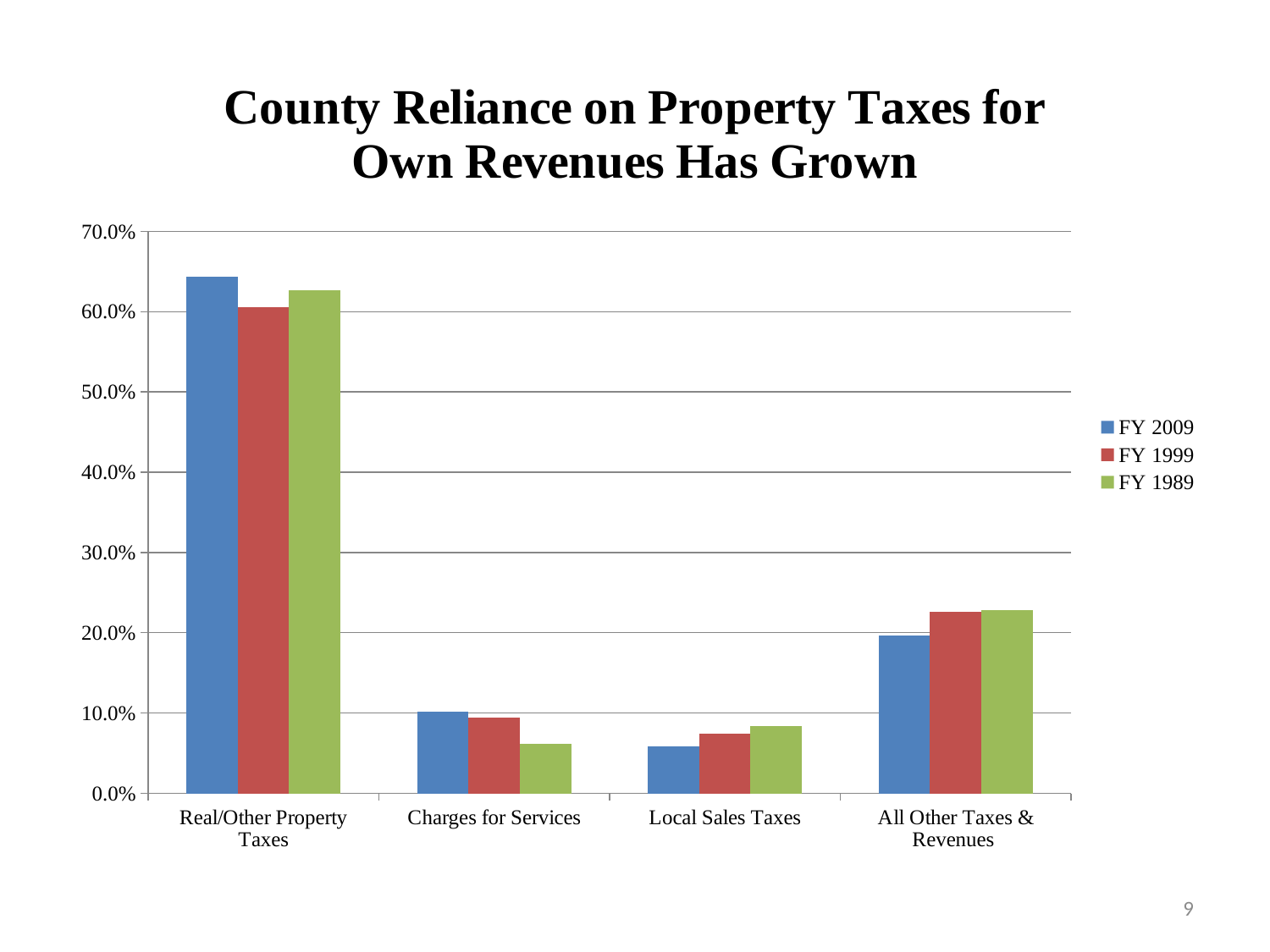
Is the FY 1989 value for Charges for Services greater or less than 10.0%? less What colour are the FY 1989 bars? Green How many series does the legend list? 3 For Local Sales Taxes, which is larger: the FY 2009 value or the FY 1989 value? FY 1989 Is the FY 1999 value for All Other Taxes & Revenues greater or less than 20.0%? greater Is the FY 2009 value for Real/Other Property Taxes greater or less than 60.0%? greater Which category has the highest FY 2009 value? Real/Other Property Taxes Which category has the lowest FY 2009 value? Local Sales Taxes For Real/Other Property Taxes, which is larger: the FY 2009 value or the FY 1999 value? FY 2009 What kind of chart is shown on the slide? Bar chart Which category has the lowest FY 1989 value? Charges for Services How many revenue categories are shown on the x axis? 4